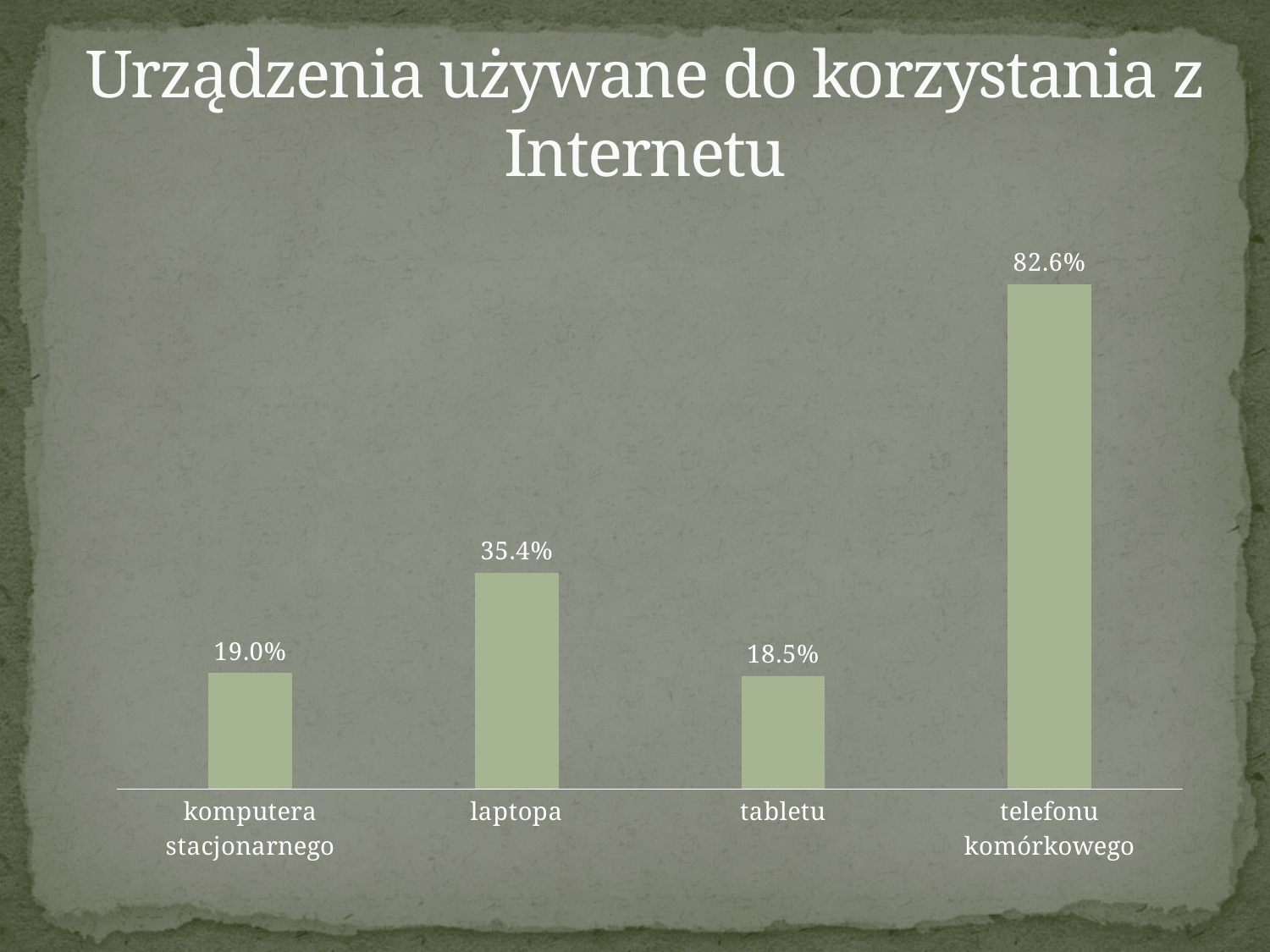
What is the value for telefonu komórkowego? 82.6% Which category has the highest value? telefonu komórkowego Which is larger, the value for laptopa or the value for komputera stacjonarnego? laptopa What is the value for tabletu? 18.5% What is the difference between the values for komputera stacjonarnego and tabletu? 0.5% What is the value for laptopa? 35.4% What is the value for komputera stacjonarnego? 19.0% Which category has the lowest value? tabletu How many categories are shown in the chart? 4 What is the title of the slide? Urządzenia używane do korzystania z Internetu What is the difference between the values for telefonu komórkowego and laptopa? 47.2% What kind of chart is shown on the slide? bar chart